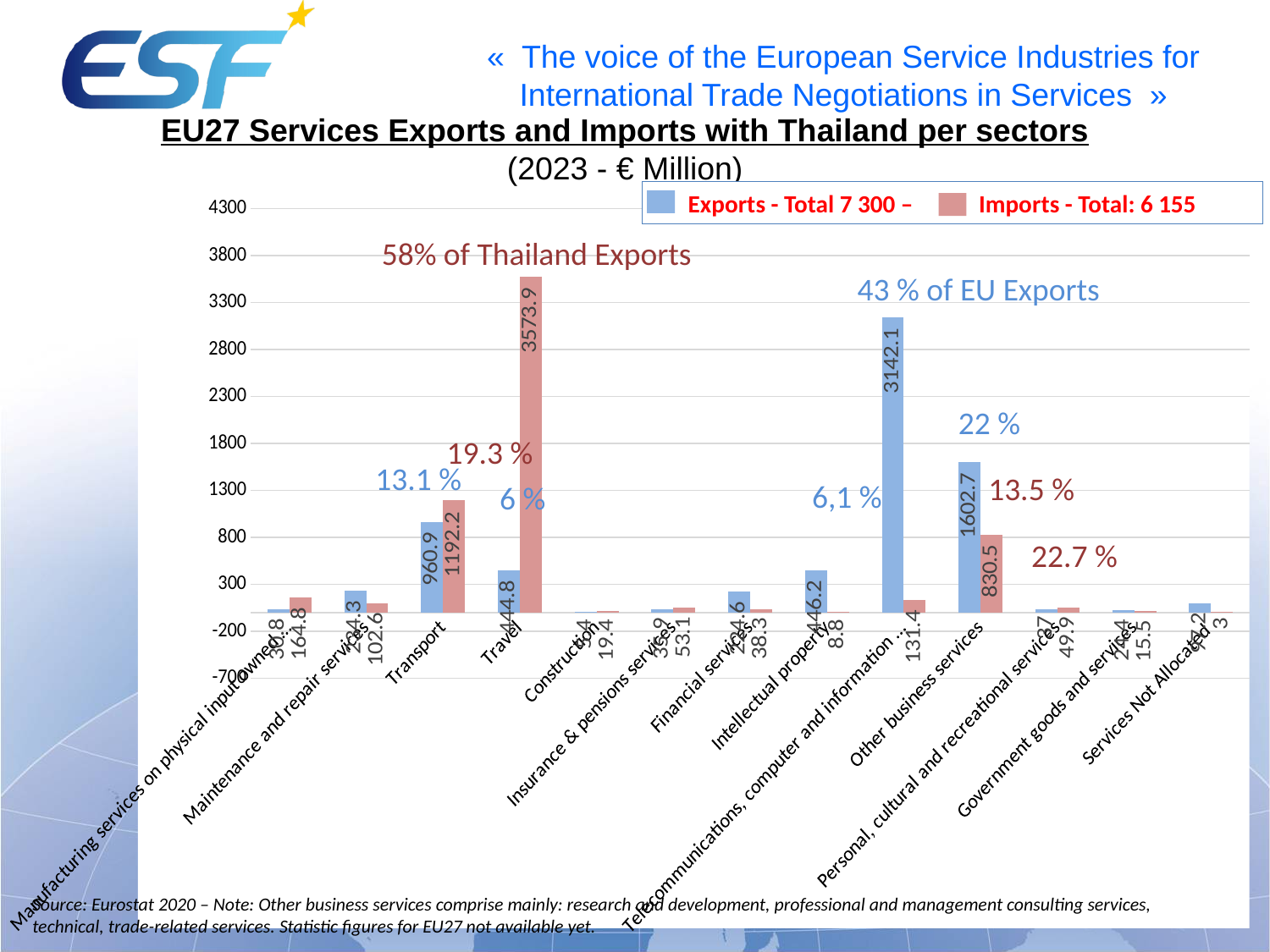
What kind of chart is shown on the slide? bar chart For Transport, which is larger: Exports or Imports? Imports What is the value of Exports for Telecommunications, computer and information? 3142.1 What is the value of Exports for Transport? 960.9 What is the difference between Exports and Imports for Other business services? 772.2 What is the value of Imports for Other business services? 830.5 What is the value of Imports for Travel? 3573.9 According to the legend, what is the total of Exports? 7 300 How many series does the legend list? 2 Which sector has the highest Imports value? Travel How many sectors are shown on the x axis? 13 Which sector has the highest Exports value? Telecommunications, computer and information